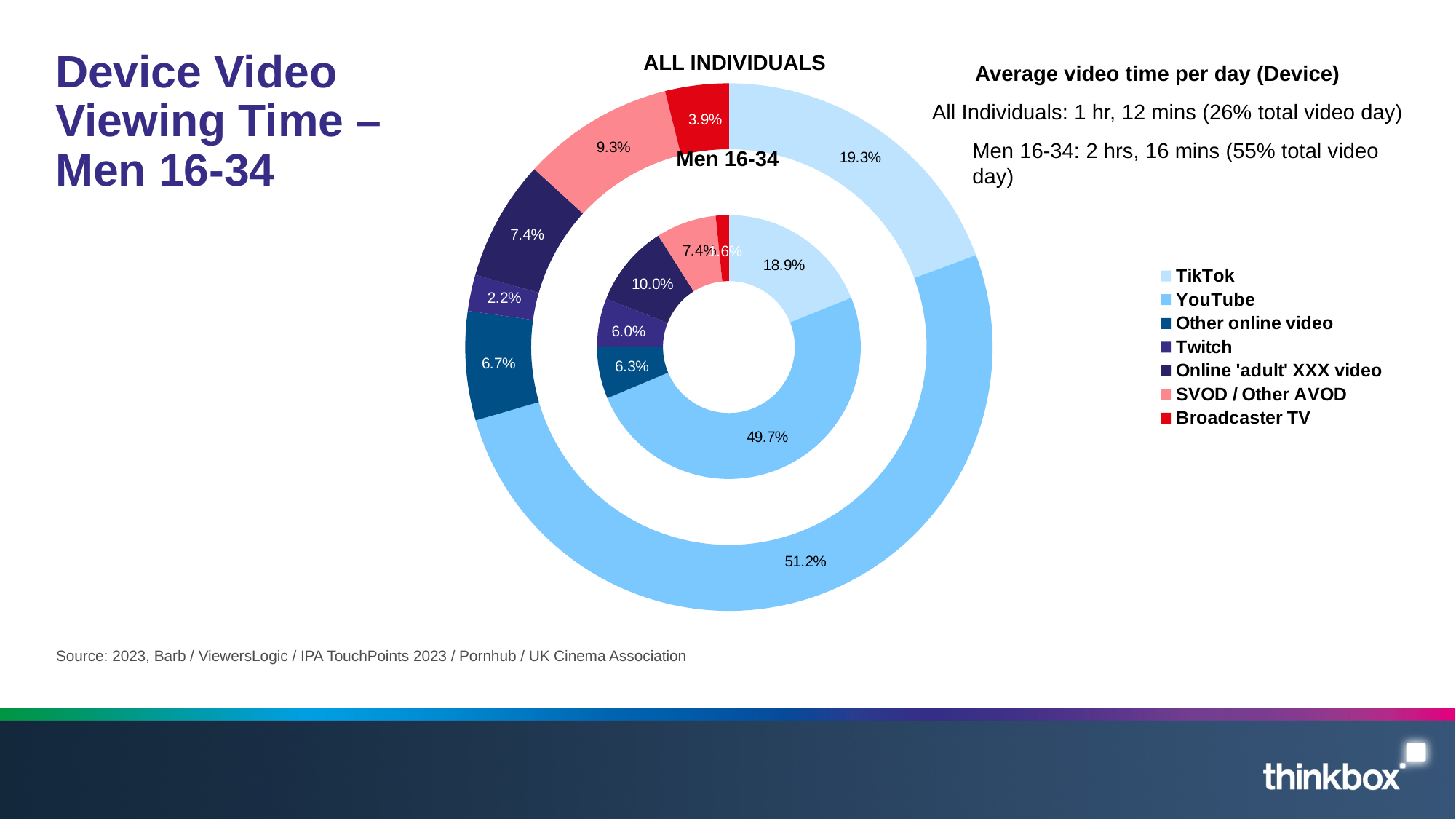
Which category has the largest share in the outer ring (All Individuals)? YouTube In the inner ring (Men 16-34), what share is Twitch? 6.0% Is the Twitch share larger for All Individuals or for Men 16-34? Men 16-34 What type of chart is shown on the slide? Doughnut chart What is the difference between the YouTube share for All Individuals (51.2%) and for Men 16-34 (49.7%)? 1.5 percentage points In the inner ring (Men 16-34), what share is Online 'adult' XXX video? 10.0% Which category has the smallest share in the outer ring (All Individuals)? Twitch How many categories does the legend list? 7 In the outer ring (All Individuals), what share of device video viewing time is YouTube? 51.2% Which ring of the doughnut chart represents Men 16-34, the inner or the outer? Inner In the outer ring (All Individuals), what share is SVOD / Other AVOD? 9.3% In the inner ring (Men 16-34), what share of device video viewing time is YouTube? 49.7%